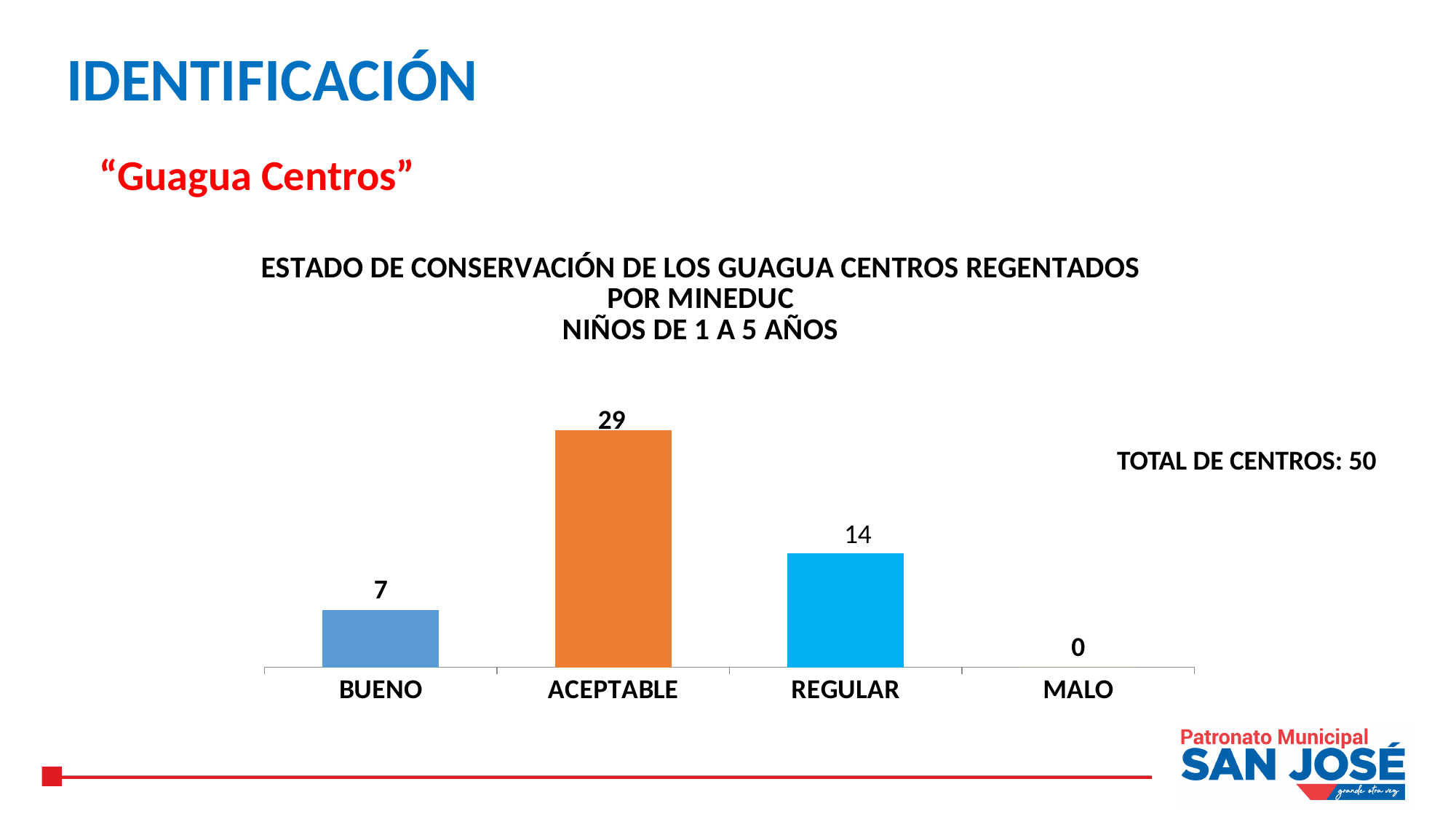
What is the value for BUENO? 7 What is the value for REGULAR? 14 How many categories are shown on the x axis? 4 What total number of centros is stated next to the chart? 50 Which is larger, the value for BUENO or the value for REGULAR? REGULAR What is the difference between the values for REGULAR and BUENO? 7 Which category has the lowest value? MALO What is the value for ACEPTABLE? 29 Which category has the highest value? ACEPTABLE What is the difference between the values for ACEPTABLE and REGULAR? 15 What kind of chart is shown on the slide? Bar chart What is the value for MALO? 0